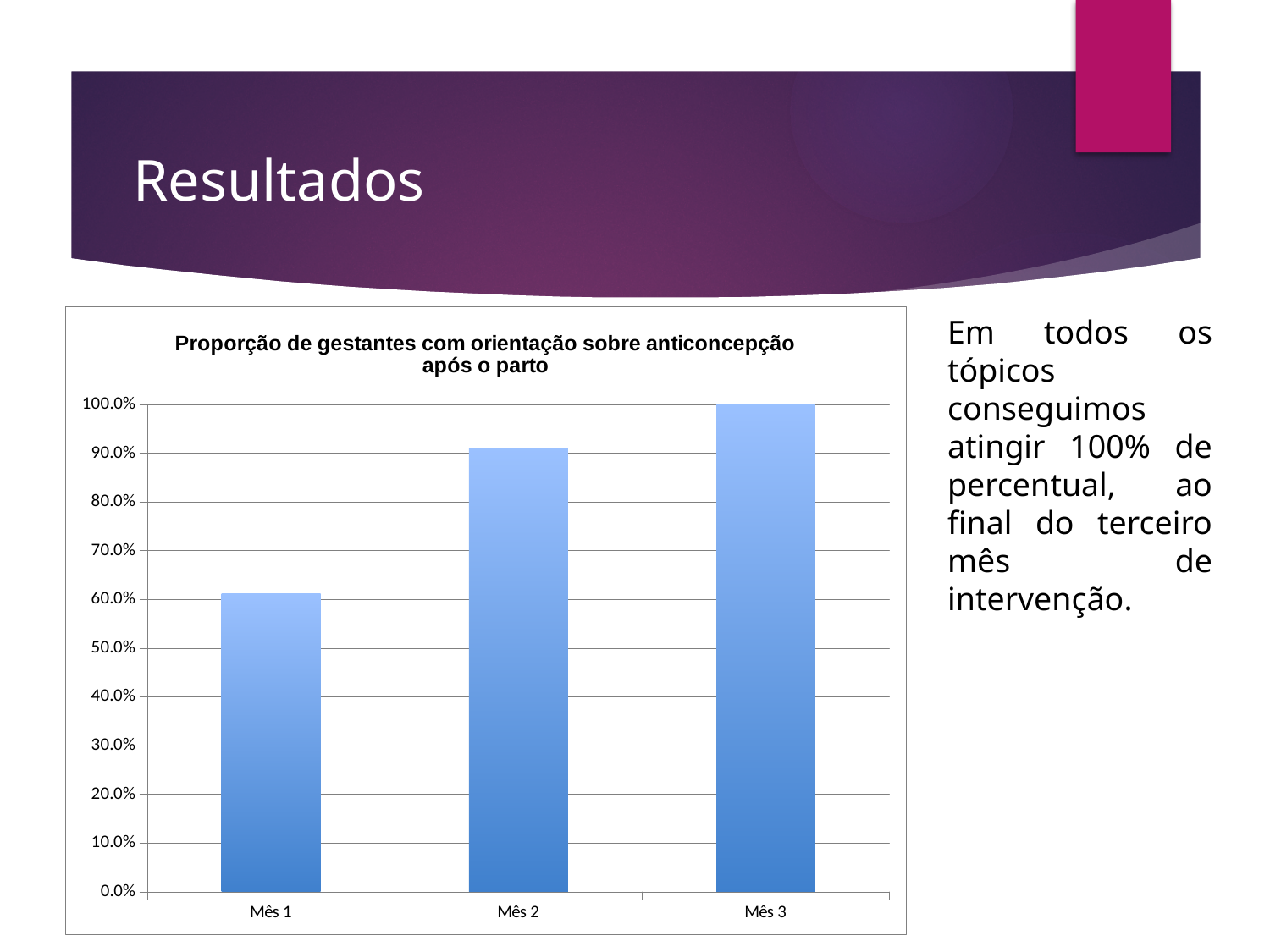
Do the values rise or fall from Mês 1 to Mês 3? rise Is the value for Mês 1 greater or less than 70.0%? less Is the value for Mês 1 greater or less than 50.0%? greater What is the title of the chart? Proporção de gestantes com orientação sobre anticoncepção após o parto Which month has the highest value in the chart? Mês 3 What is the value for Mês 3? 100.0% Which is larger, the value for Mês 1 or the value for Mês 2? Mês 2 How many categories (months) are plotted in the chart? 3 Which month has the lowest value in the chart? Mês 1 Is the value for Mês 2 greater or less than 80.0%? greater What kind of chart is shown on the slide? bar chart What is the highest value shown on the vertical axis of the chart? 100.0%